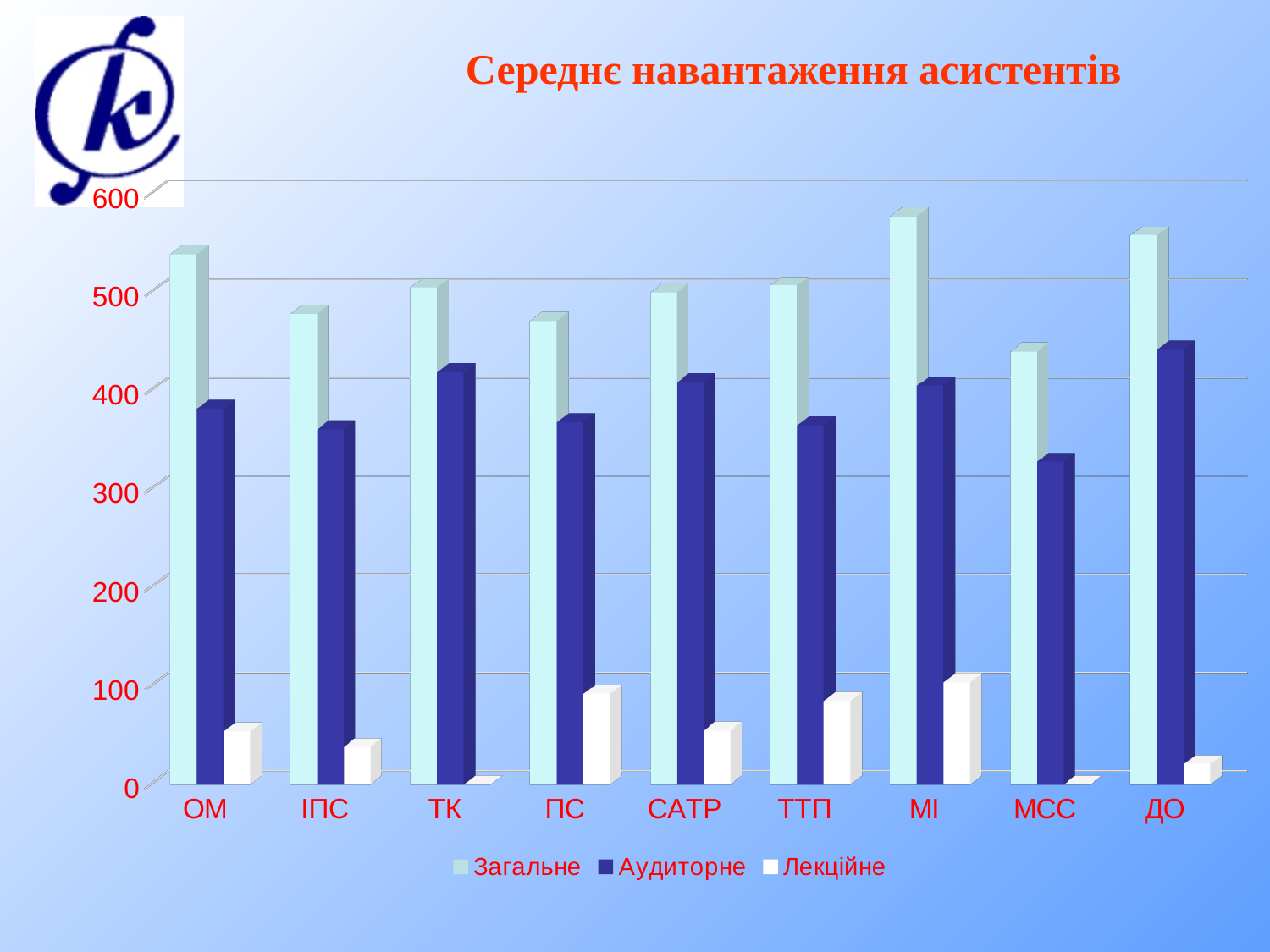
Is the Загальне value for МІ greater or less than 500? greater Which category has the lowest value for the Загальне series? МСС Which is larger, the Аудиторне value for ТК or for ІПС? ТК Is the Загальне value for МСС greater or less than 500? less What kind of chart is shown on the slide? bar chart Which is larger, the Загальне value for ОМ or for ІПС? ОМ Is the Аудиторне value for ІПС greater or less than 400? less How many categories are shown on the x axis? 9 Which category has the lowest value for the Аудиторне series? МСС Which category has the highest value for the Загальне series? МІ What is the title of the chart? Середнє навантаження асистентів How many series does the legend list? 3